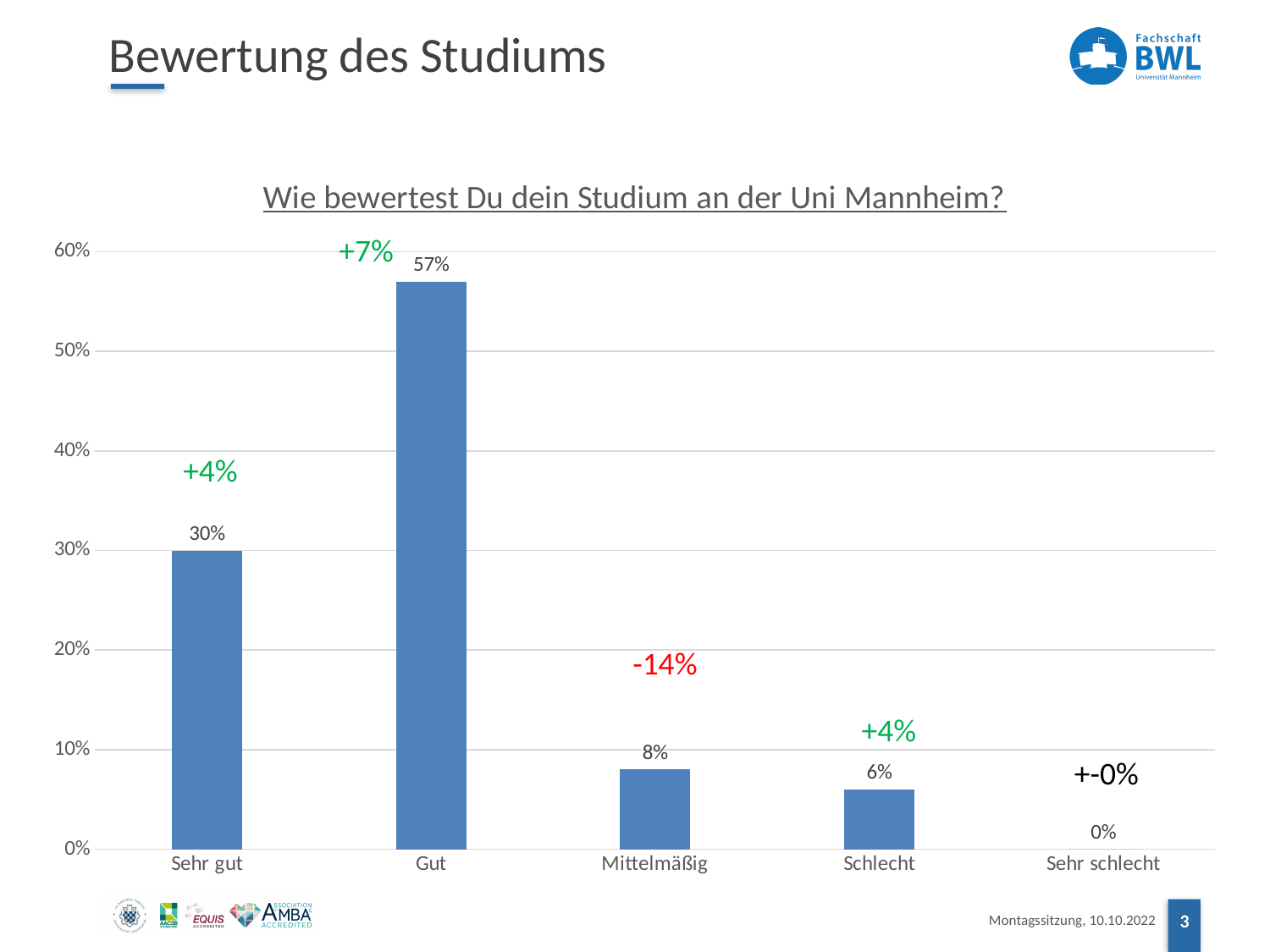
Which category has the highest value? Gut What is the value shown for "Sehr schlecht"? 0% How many categories are shown on the x axis? 5 What is the difference between the values for "Gut" and "Sehr gut"? 27% What kind of chart is shown on the slide? Bar chart What percentage of respondents rated their studies as "Gut"? 57% What change annotation is shown above the "Mittelmäßig" bar? -14% What is the value shown for "Sehr gut"? 30% What is the value shown for "Mittelmäßig"? 8% Which is larger, the value for "Mittelmäßig" or the value for "Schlecht"? Mittelmäßig Which category has the lowest value? Sehr schlecht What is the question shown as the chart title? Wie bewertest Du dein Studium an der Uni Mannheim?